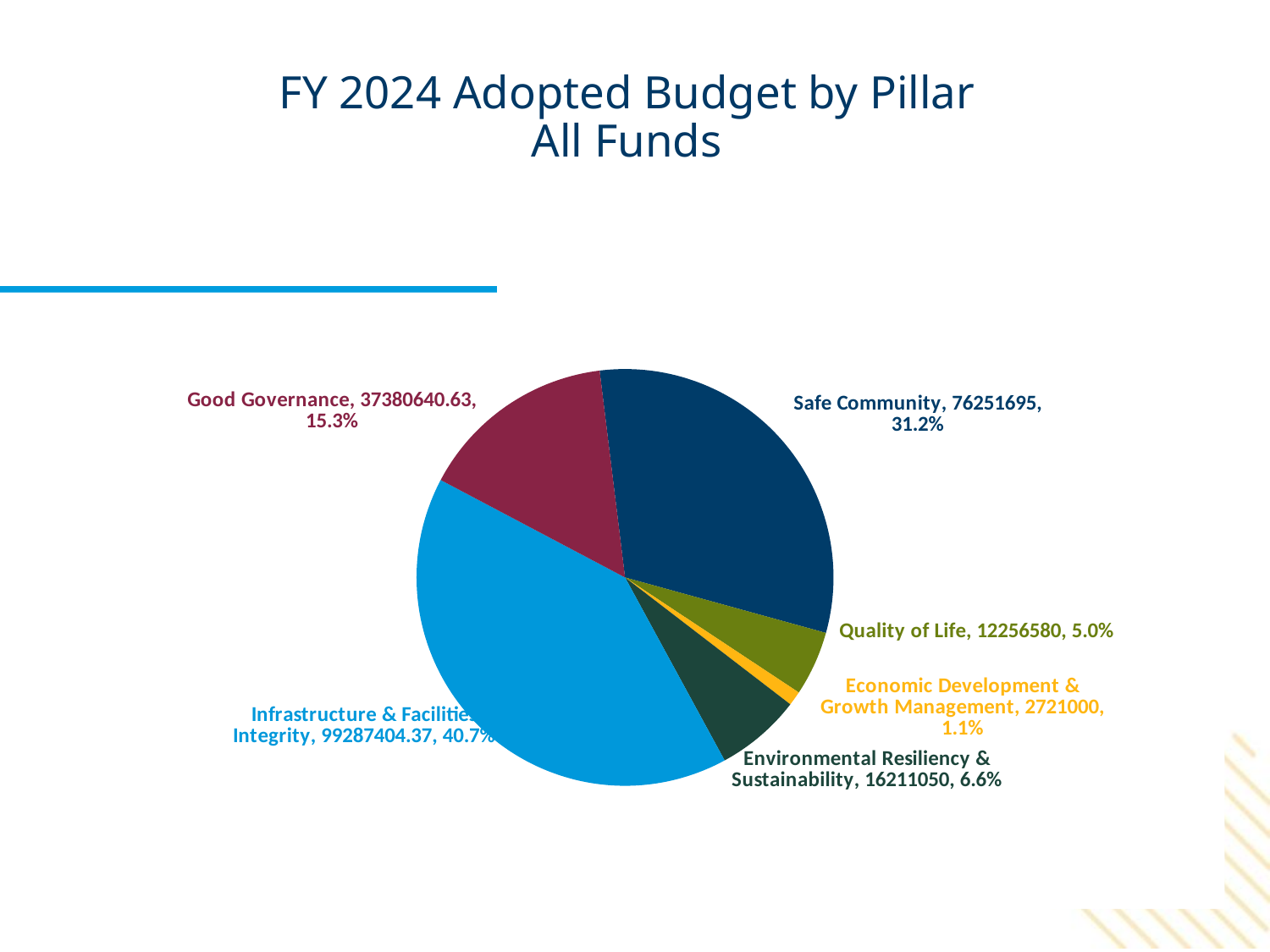
What is the value for Good Governance? 37380640.63 What is the title of the chart? FY 2024 Adopted Budget by Pillar All Funds What share of the pie does Environmental Resiliency & Sustainability represent? 6.6% What kind of chart is shown on the slide? pie chart What is the difference between the value for Quality of Life and the value for Economic Development & Growth Management? 9535580 What share of the pie does Economic Development & Growth Management represent? 1.1% What is the value for Safe Community? 76251695 How many slices does the pie chart have? 6 What is the value for Infrastructure & Facilities Integrity? 99287404.37 Which pillar has the smallest slice of the pie? Economic Development & Growth Management Which is larger, the value for Quality of Life or the value for Environmental Resiliency & Sustainability? Environmental Resiliency & Sustainability Which pillar has the largest slice of the pie? Infrastructure & Facilities Integrity